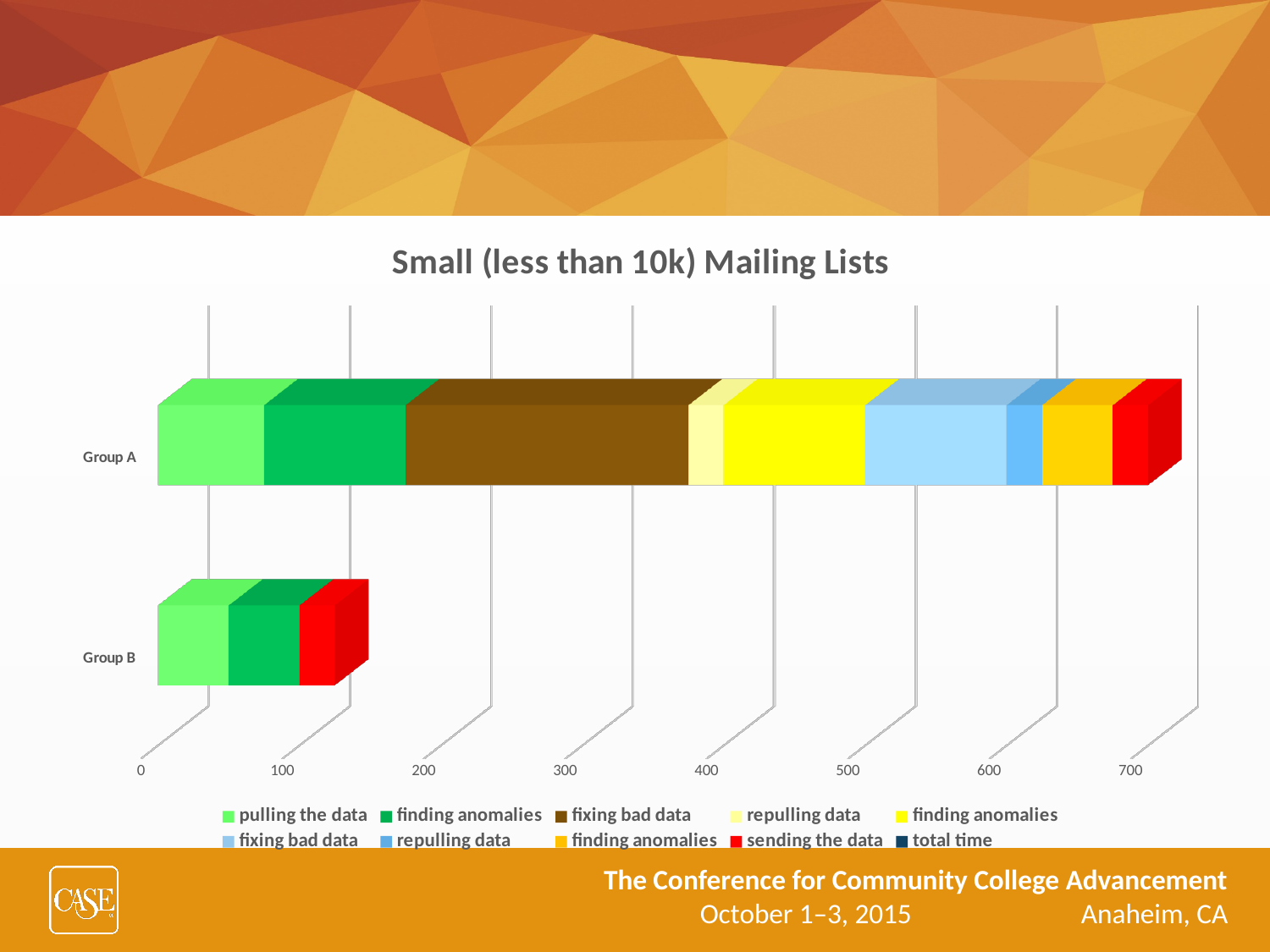
How many series does the legend list? 10 Which group has the longer total bar? Group A How many groups (categories) are plotted on the chart? 2 Is the total bar for Group A greater or less than 600? greater Is the total bar for Group B greater or less than 200? less Which legend entry is shown in red? sending the data Which group has the shorter total bar? Group B What is the title of the chart? Small (less than 10k) Mailing Lists Is the total bar for Group A greater or less than 500? greater What kind of chart is shown on the slide? bar chart Which is larger, the total for Group A or the total for Group B? Group A What is the highest value shown on the horizontal axis? 700